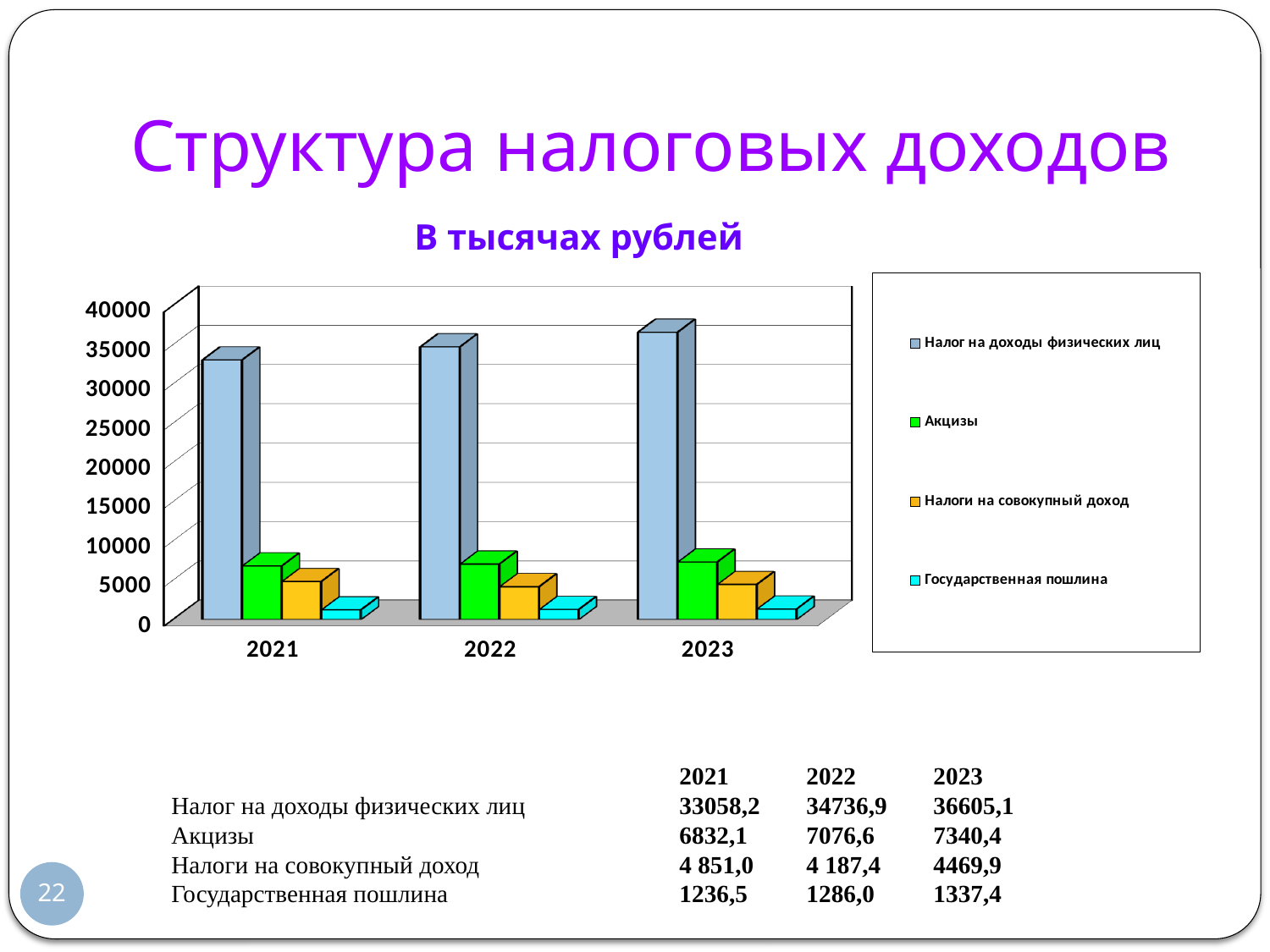
What is the value of Акцизы for 2021? 6832,1 Which is larger: Налоги на совокупный доход in 2021 or in 2022? 2021 Is the value for Налог на доходы физических лиц in 2023 greater or less than 35000? greater What is the value of Налог на доходы физических лиц for 2023? 36605,1 By how much did Налог на доходы физических лиц increase from 2021 to 2023? 3546,9 Which series has the lowest value in 2023? Государственная пошлина Does the value of Акцизы rise or fall from 2021 to 2023? rise What is the value of Государственная пошлина for 2022? 1286,0 What type of chart is shown on the slide? bar chart Which series has the highest value in 2022? Налог на доходы физических лиц How many years are shown on the x axis of the chart? 3 How many series does the legend list? 4